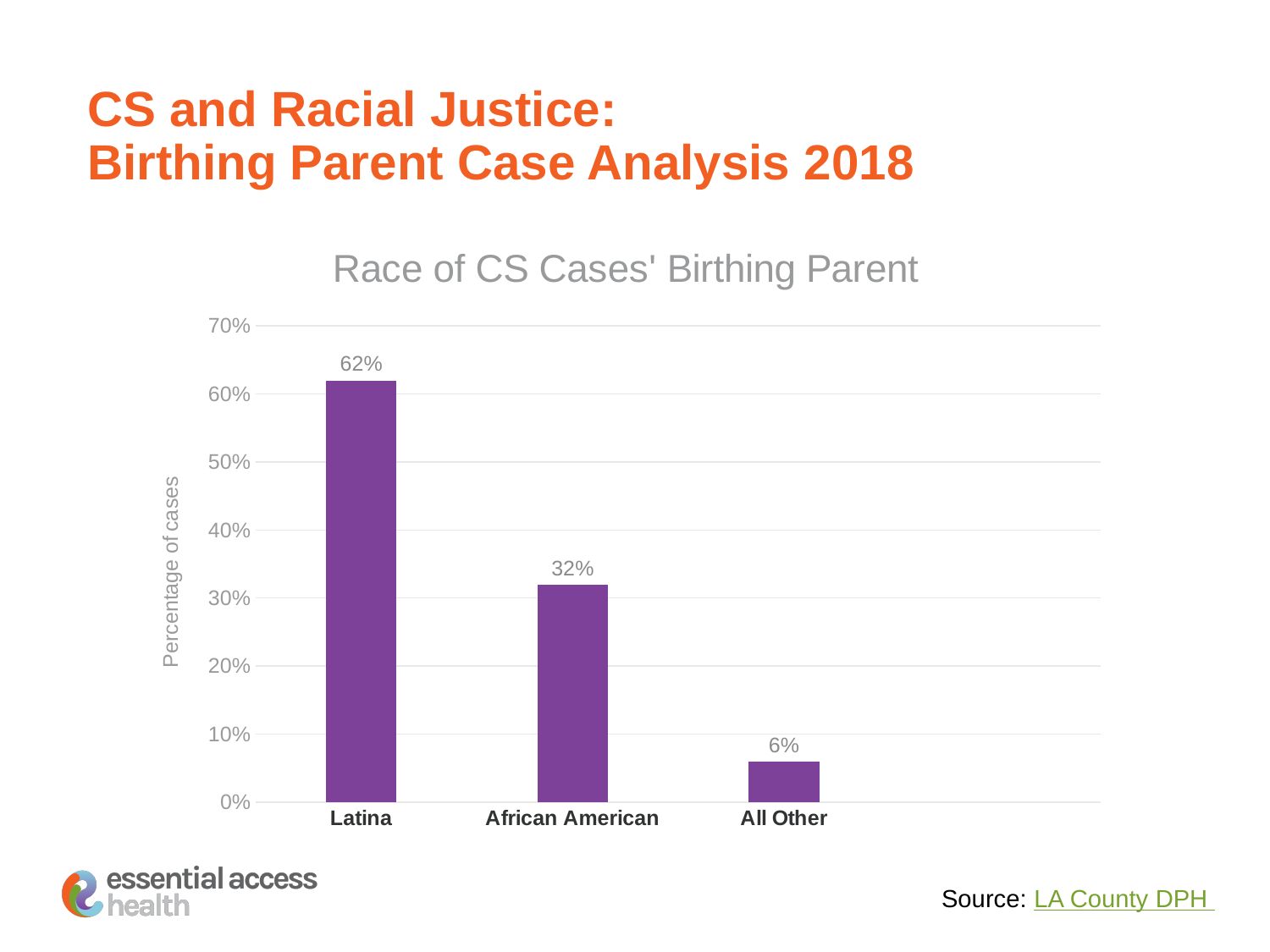
Which category has the lowest percentage of cases? All Other Which category has the highest percentage of cases? Latina What is the value shown for African American? 32% What is the value shown for All Other? 6% Is the value for Latina greater or less than 60%? greater What is the difference between the Latina and African American percentages? 30% What is the difference between the African American and All Other percentages? 26% What kind of chart is shown on the slide? Bar chart What is the title of the chart? Race of CS Cases' Birthing Parent How many categories are shown on the x axis? 3 What percentage of CS cases' birthing parents are Latina? 62% Which is larger, the value for African American or the value for All Other? African American